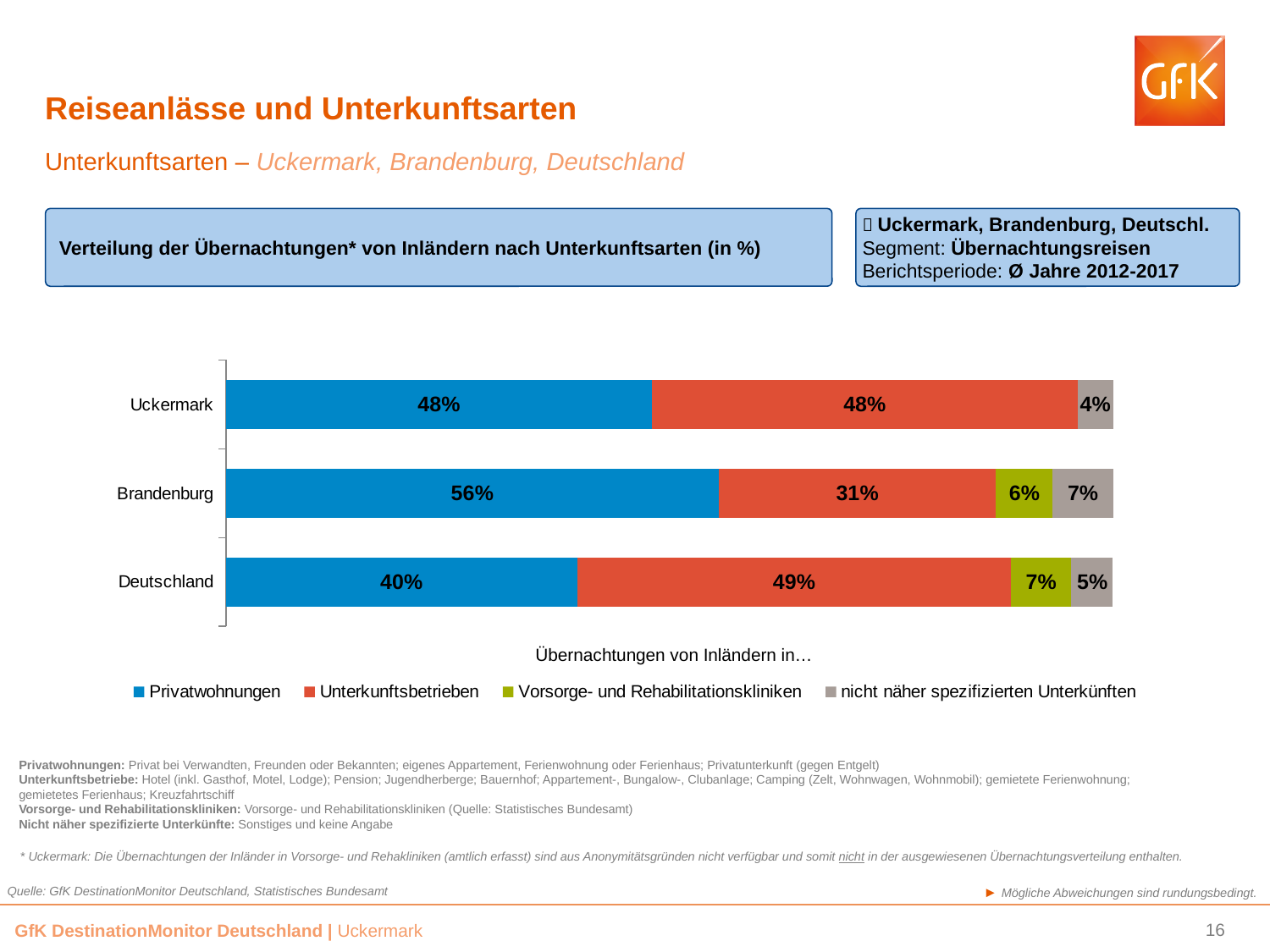
Which colour represents Privatwohnungen in the chart? Blue What kind of chart is shown on the slide? Stacked bar chart What is the difference between the Privatwohnungen share for Brandenburg and for Deutschland? 16% Which region has the lowest share of overnight stays in Unterkunftsbetrieben? Brandenburg How many series does the legend list? 4 How many regions are shown in the chart? 3 What is the value for Unterkunftsbetrieben for Deutschland? 49% Which is larger: the Unterkunftsbetrieben share for Uckermark or for Brandenburg? Uckermark What share of domestic overnight stays in Brandenburg are in Privatwohnungen? 56% What is the value for Vorsorge- und Rehabilitationskliniken for Brandenburg? 6% Which region has the highest share of overnight stays in Privatwohnungen? Brandenburg What is the value for nicht näher spezifizierten Unterkünften for Uckermark? 4%